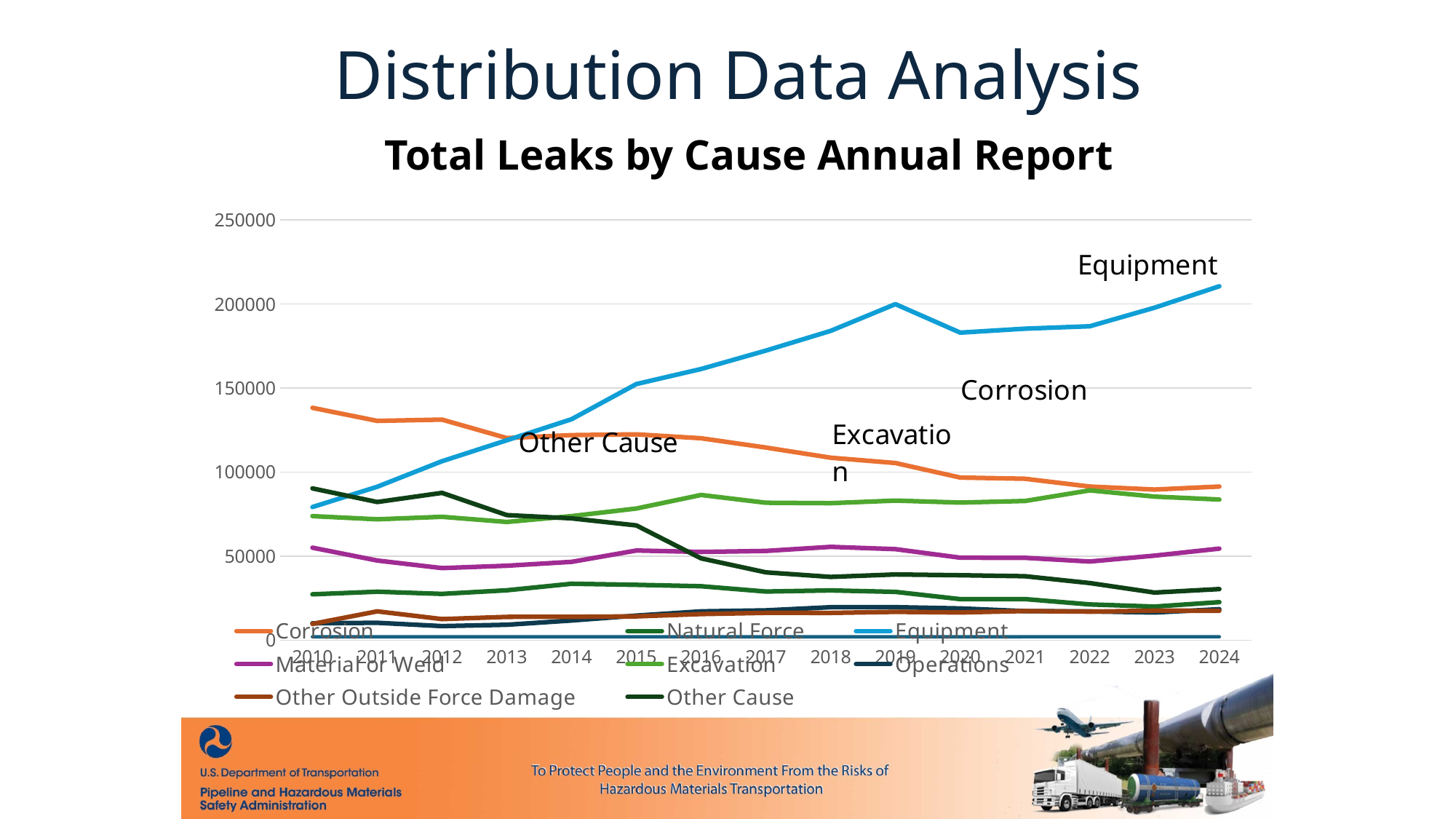
Is the value for Corrosion in 2024 greater or less than 100000? less Is the value for Corrosion in 2010 greater or less than 150000? less Is the value for Equipment in 2024 greater or less than 200000? greater In 2010, which is larger: Corrosion or Equipment? Corrosion In 2024, which is larger: Excavation or Material or Weld? Excavation Does the Equipment line generally rise or fall from 2010 to 2024? rise Does the Corrosion line generally rise or fall from 2010 to 2024? fall How many years are plotted along the x axis? 15 What kind of chart is shown on the slide? line chart How many series does the legend list? 8